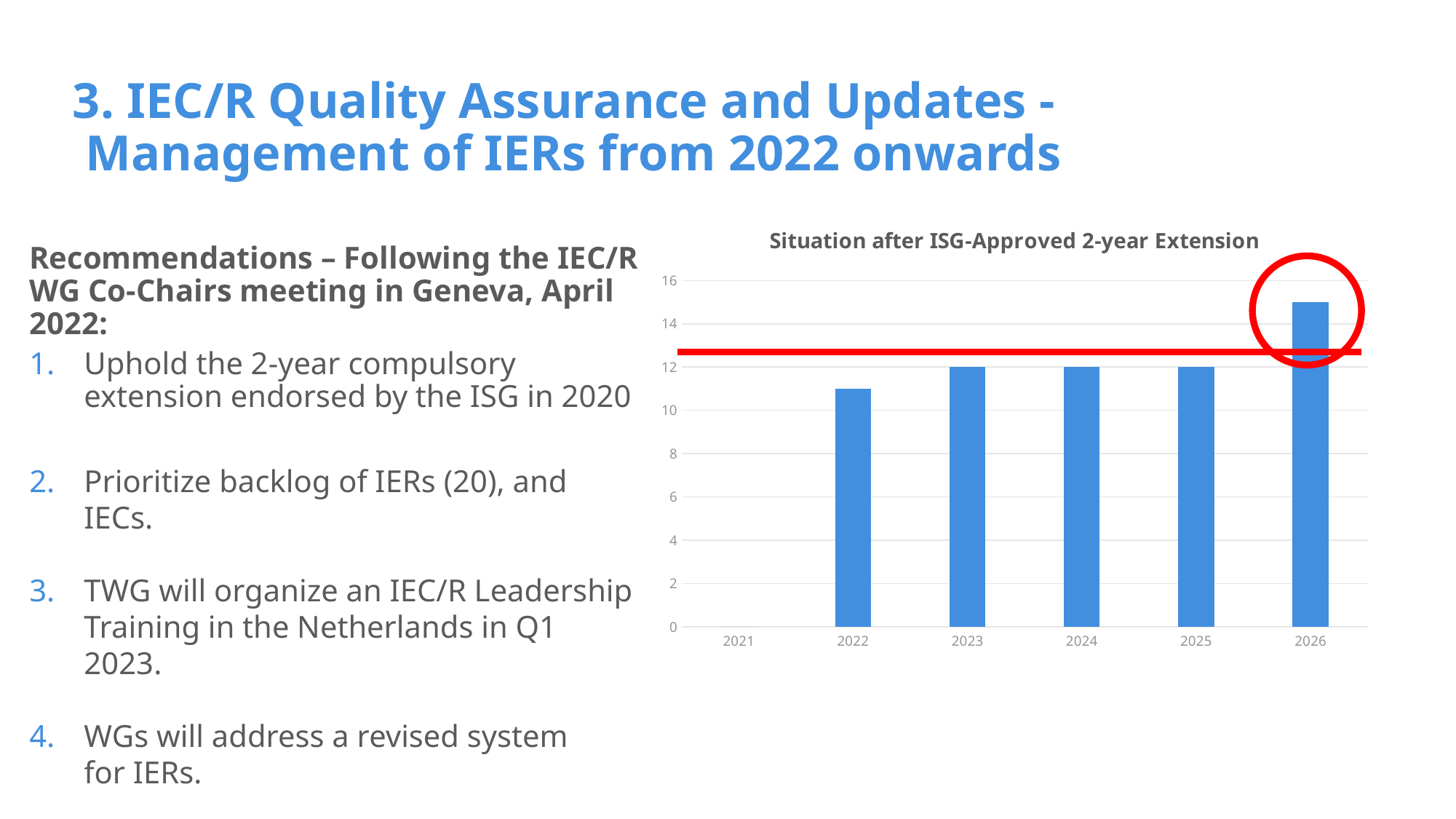
What is the value for 2025 in the chart? 12 Which year has the lowest value in the chart? 2021 Is the value for 2026 greater or less than 14? greater Do the bar values generally rise or fall from 2021 to 2026? rise How many years are shown on the x axis of the chart? 6 Is the value for 2022 greater or less than 12? less Which year has the tallest bar in the chart? 2026 Which year's bar is highlighted with a red circle on the chart? 2026 What is the title of the chart? Situation after ISG-Approved 2-year Extension What kind of chart is shown on the slide? bar chart Which is larger, the value for 2022 or the value for 2026? 2026 What is the value for 2023 in the chart? 12